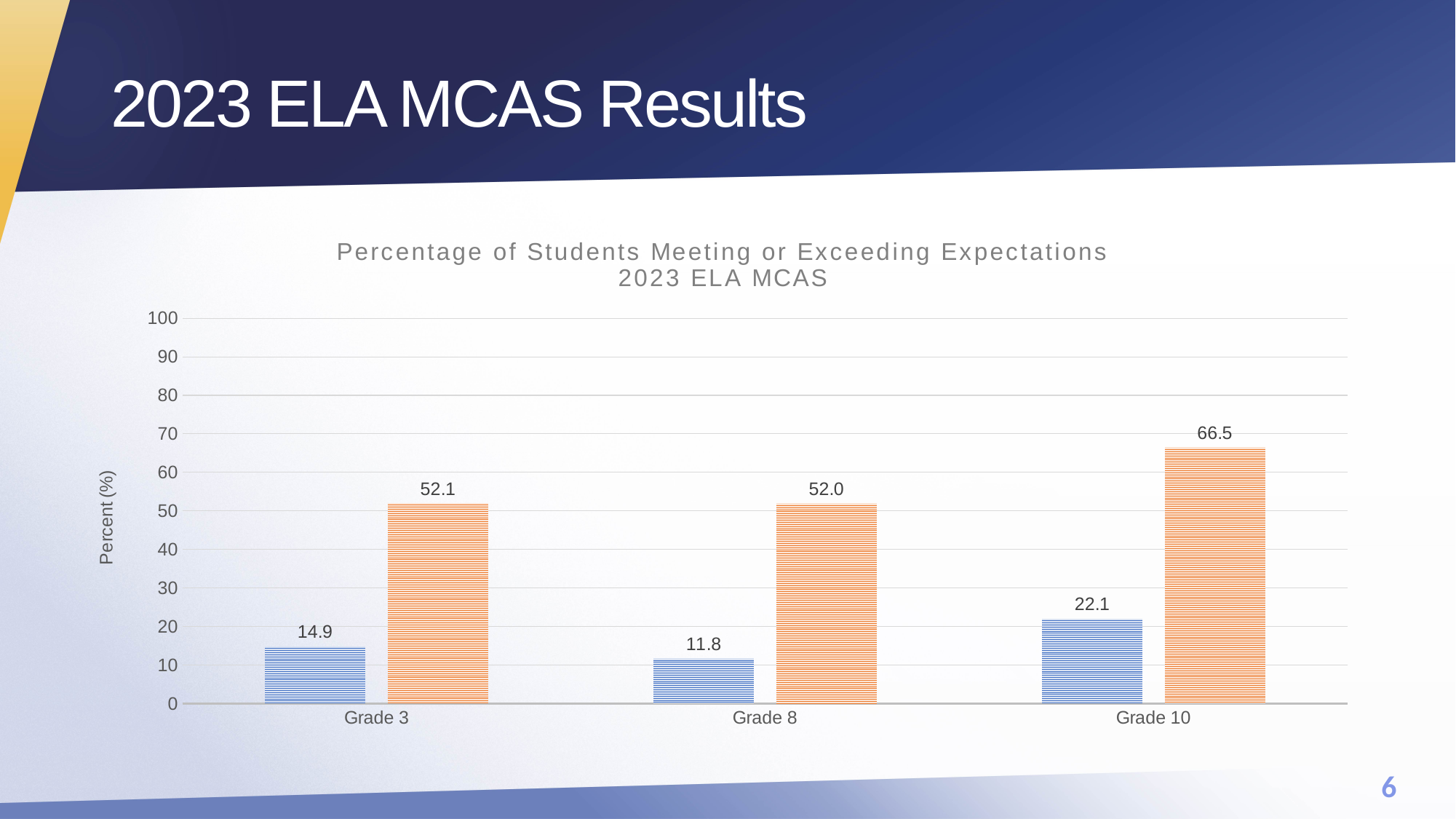
What is the value of the orange bar for Grade 10? 66.5 How many grade categories are shown on the x axis? 3 Which grade has the lowest blue bar? Grade 8 What is the difference between the orange bar and the blue bar for Grade 10? 44.4 What is the value of the orange bar for Grade 8? 52.0 What type of chart is shown on the slide? bar chart What is the value of the blue bar for Grade 8? 11.8 What is the label of the vertical axis? Percent (%) Which grade has the highest orange bar? Grade 10 Which is larger: the blue bar for Grade 3 or the blue bar for Grade 10? Grade 10 Is the value of the orange bar for Grade 3 greater or less than 50? greater What is the value of the blue bar for Grade 3? 14.9